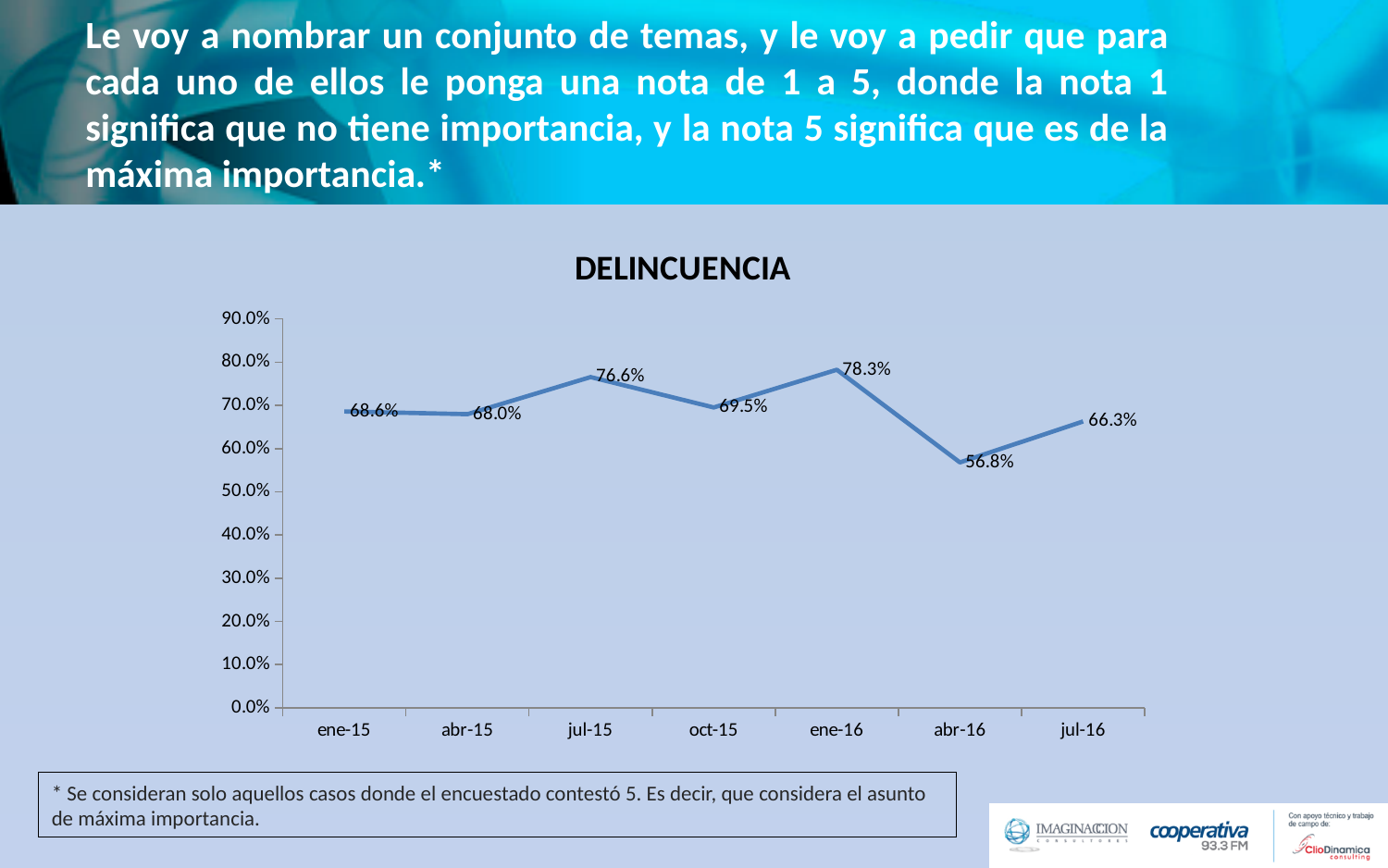
Which period has the highest value in the DELINCUENCIA chart? ene-16 What is the value for jul-15 in the DELINCUENCIA chart? 76.6% Is the value for jul-16 in the DELINCUENCIA chart greater or less than 60.0%? greater What is the difference between the values for ene-16 and abr-16 in the DELINCUENCIA chart? 21.5% Which period has the lowest value in the DELINCUENCIA chart? abr-16 What is the value for ene-15 in the DELINCUENCIA chart? 68.6% What is the title of the chart on the slide? DELINCUENCIA Does the value rise or fall from ene-16 to abr-16 in the DELINCUENCIA chart? fall How many data points are plotted in the DELINCUENCIA chart? 7 Which is larger in the DELINCUENCIA chart, the value for jul-15 or the value for oct-15? jul-15 What kind of chart is the DELINCUENCIA chart? line chart What is the value for abr-16 in the DELINCUENCIA chart? 56.8%